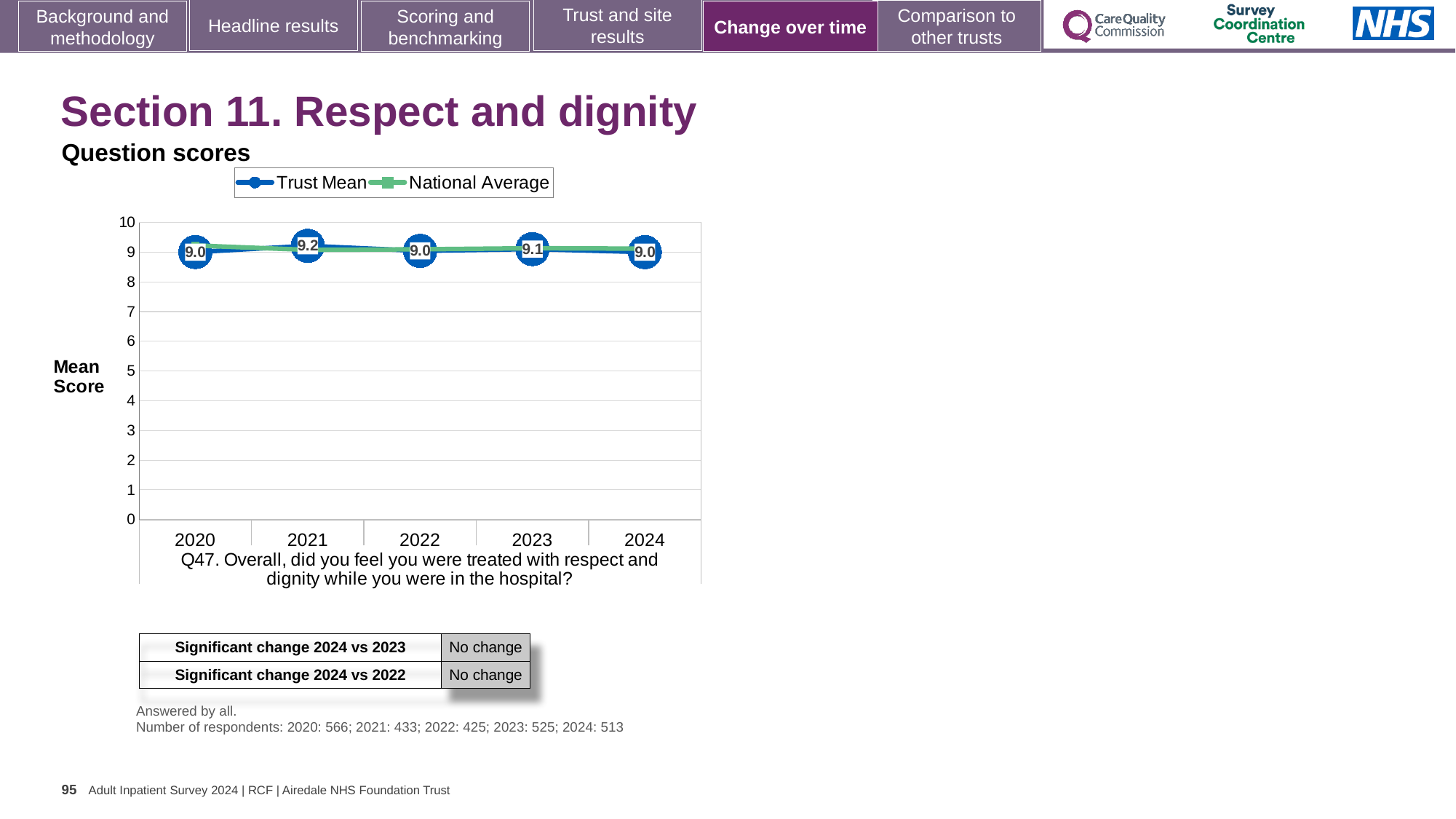
Is the National Average value for 2022 greater or less than 8? greater What is the Trust Mean value for 2020? 9.0 What is the label of the y axis? Mean Score How many series does the legend list? 2 What is the Trust Mean value for 2024? 9.0 Which year has the larger Trust Mean, 2021 or 2022? 2021 How many years are plotted on the x axis? 5 In which year is the Trust Mean highest? 2021 What kind of chart is shown on the slide? line chart What is the Trust Mean value for 2023? 9.1 What is the difference between the Trust Mean in 2021 and in 2020? 0.2 What is the Trust Mean value for 2021? 9.2